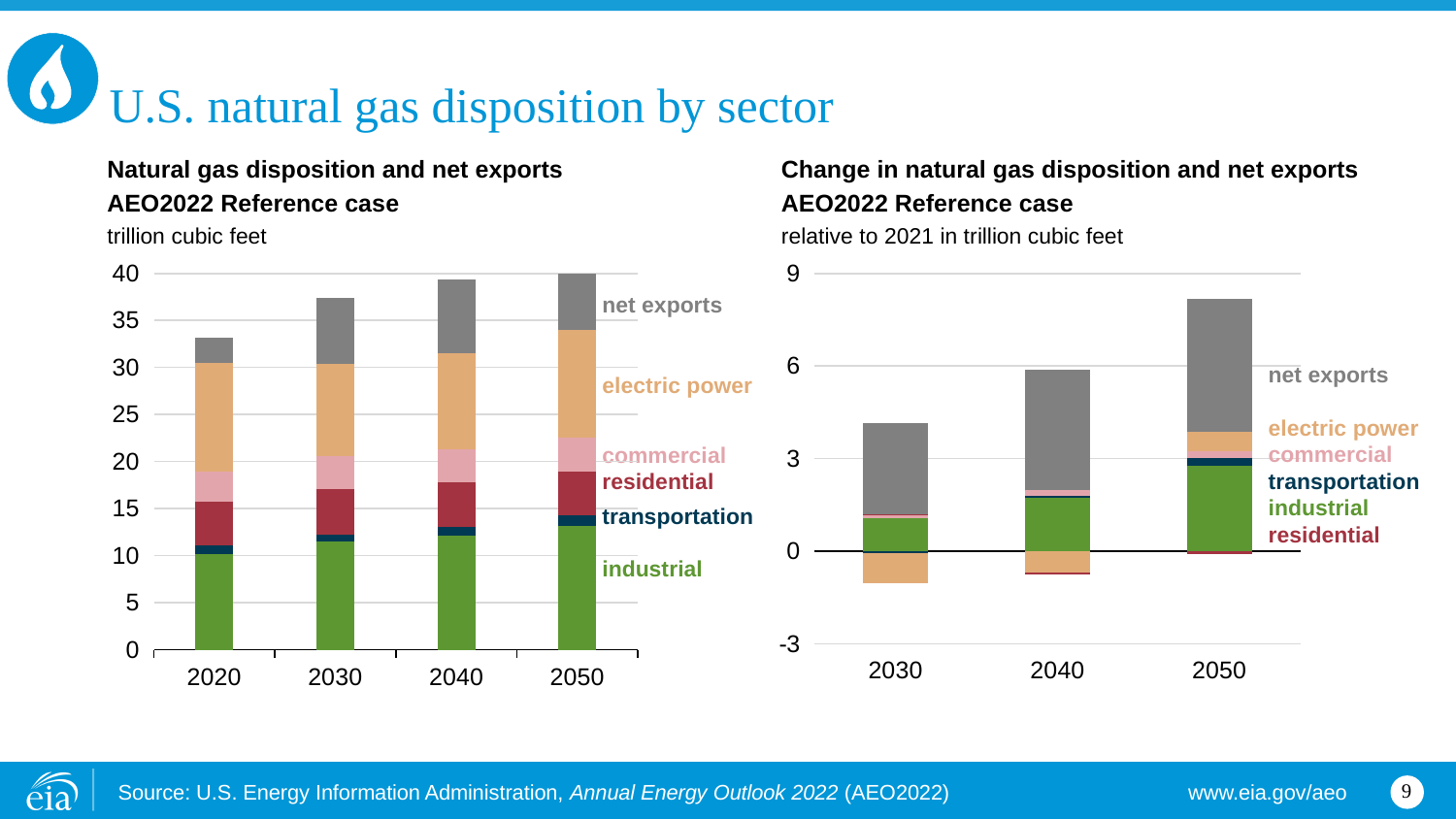
On the right chart, 'Change in natural gas disposition and net exports', is the top of the 2050 bar greater or less than 6? greater On the left chart, 'Natural gas disposition and net exports', is the total bar for 2030 greater or less than 35 trillion cubic feet? greater How many years are shown on the x axis of the right chart, 'Change in natural gas disposition and net exports'? 3 What kind of chart is the left chart, 'Natural gas disposition and net exports'? stacked bar chart How many years are shown on the x axis of the left chart, 'Natural gas disposition and net exports'? 4 On the left chart, 'Natural gas disposition and net exports', do the total bars rise or fall from 2020 to 2050? rise On the right chart, 'Change in natural gas disposition and net exports', which sector has a negative change (below zero) in 2030? electric power What unit is used on the left chart, 'Natural gas disposition and net exports'? trillion cubic feet How many sectors/series are labelled on the left chart, 'Natural gas disposition and net exports'? 6 On the left chart, 'Natural gas disposition and net exports', is the total bar for 2020 greater or less than 30 trillion cubic feet? greater On the left chart, 'Natural gas disposition and net exports', which year has the taller total bar, 2020 or 2050? 2050 On the right chart, 'Change in natural gas disposition and net exports', do the positive bars rise or fall from 2030 to 2050? rise